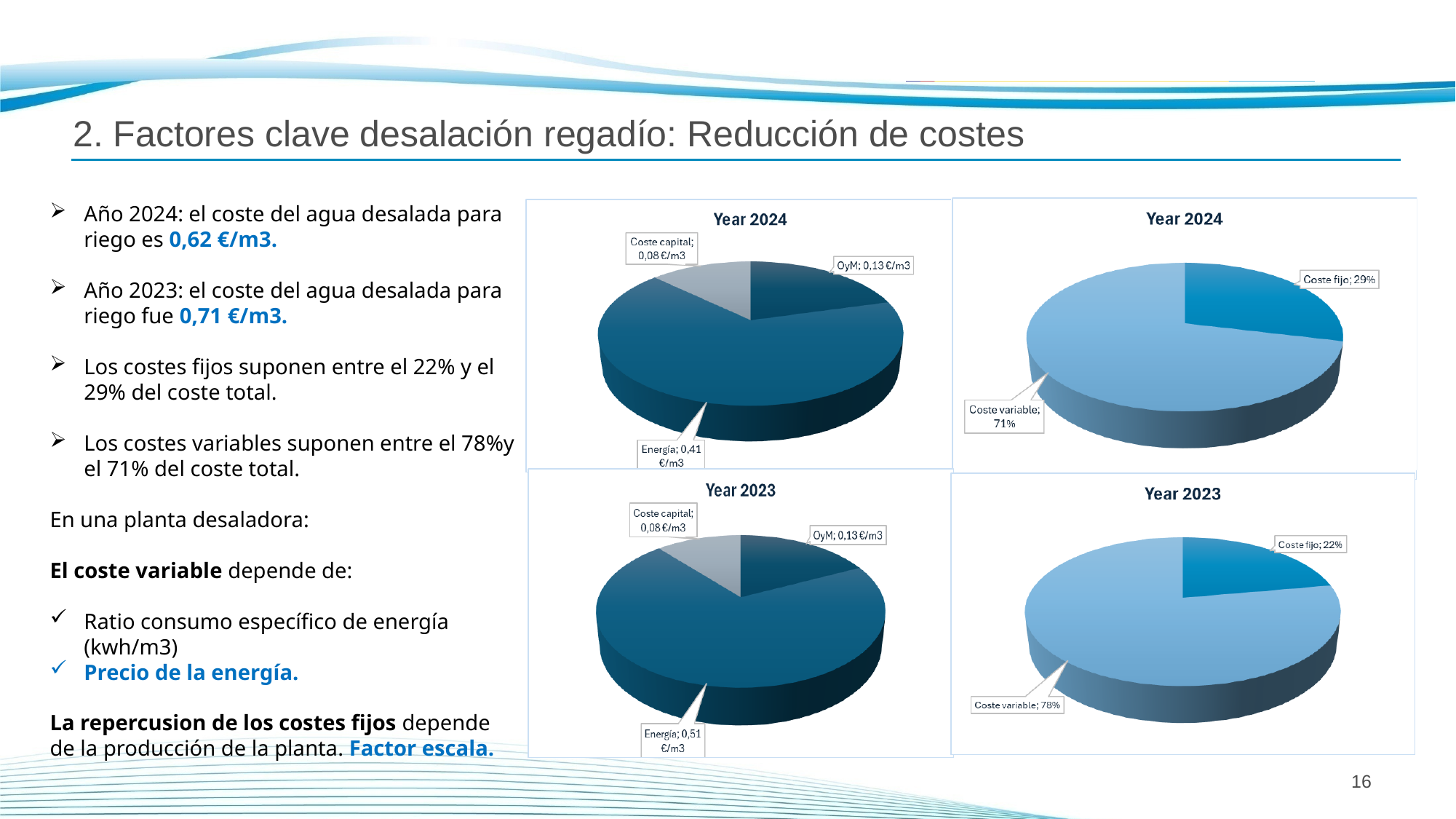
In the bottom-left pie chart (Year 2023), which category has the smallest value? Coste capital How many slices does the bottom-left pie chart (Year 2023) have? 3 In the top-left pie chart (Year 2024), what is the value for OyM? 0,13 €/m3 In the top-right pie chart (Year 2024), what share does Coste fijo represent? 29% In the bottom-right pie chart (Year 2023), what share does Coste variable represent? 78% In the bottom-left pie chart (Year 2023), what is the value for Coste capital? 0,08 €/m3 What is the difference between the Energía value in the bottom-left chart (Year 2023) and the Energía value in the top-left chart (Year 2024)? 0,10 €/m3 In the top-left pie chart (Year 2024), which is larger: OyM or Coste capital? OyM What type of chart is the top-right chart (Year 2024)? Pie chart In the top-left pie chart (Year 2024), what is the value for Energía? 0,41 €/m3 In the top-left pie chart (Year 2024), which category has the largest value? Energía In the bottom-left pie chart (Year 2023), what is the value for Energía? 0,51 €/m3